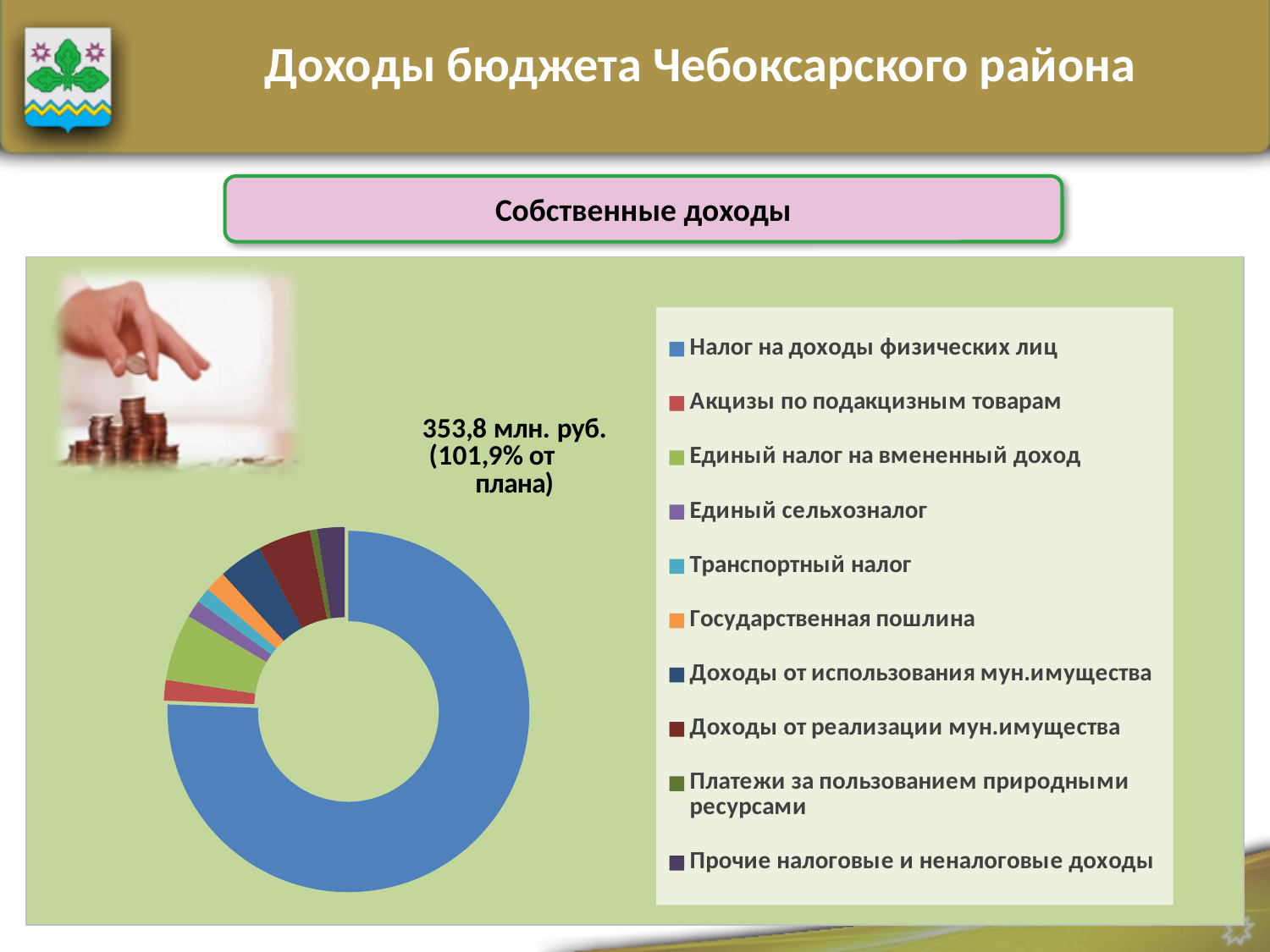
What percentage of the plan is printed next to the chart? 101,9% Which category has the largest share of the chart? Налог на доходы физических лиц Which is larger: the share for Налог на доходы физических лиц or the share for Единый налог на вмененный доход? Налог на доходы физических лиц What total amount is printed next to the chart? 353,8 млн. руб. What kind of chart is shown on the slide? Doughnut (pie) chart Which is larger: the share for Единый налог на вмененный доход or the share for Акцизы по подакцизным товарам? Единый налог на вмененный доход How many categories does the legend of the chart list? 10 Which is larger: the share for Доходы от использования мун.имущества or the share for Транспортный налог? Доходы от использования мун.имущества